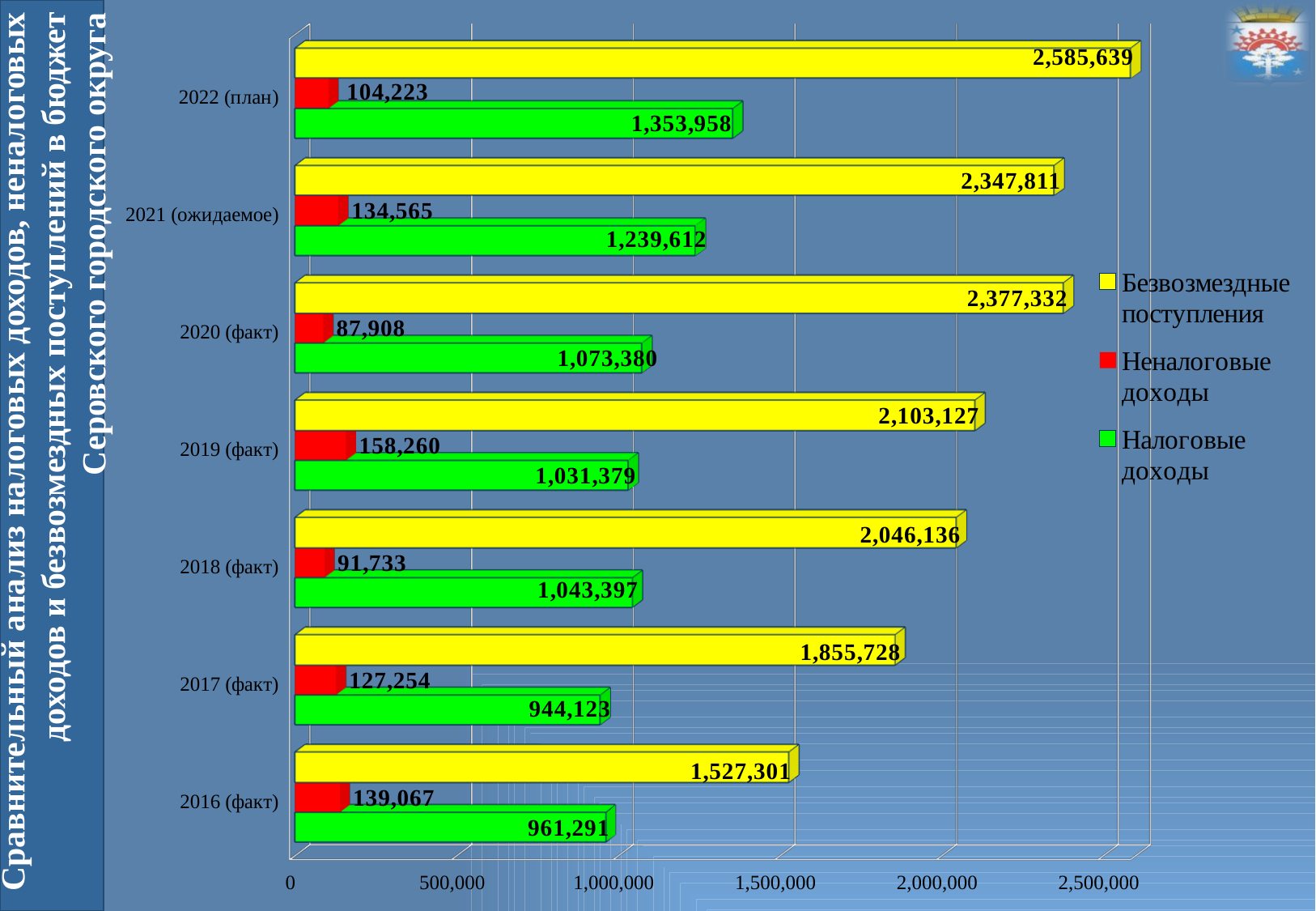
How many year categories are shown on the chart? 7 What is the value of Налоговые доходы for 2019 (факт)? 1,031,379 What is the value of Безвозмездные поступления for 2022 (план)? 2,585,639 What kind of chart is shown on the slide? bar chart Is the value of Налоговые доходы for 2022 (план) greater or less than 1,000,000? greater In which year are Налоговые доходы the lowest? 2017 (факт) What is the value of Неналоговые доходы for 2017 (факт)? 127,254 In which year are Неналоговые доходы the lowest? 2020 (факт) What is the difference between Безвозмездные поступления in 2022 (план) and 2021 (ожидаемое)? 237,828 Which is larger: Безвозмездные поступления in 2020 (факт) or in 2021 (ожидаемое)? 2020 (факт) In which year are Неналоговые доходы the highest? 2019 (факт) How many series does the legend list? 3